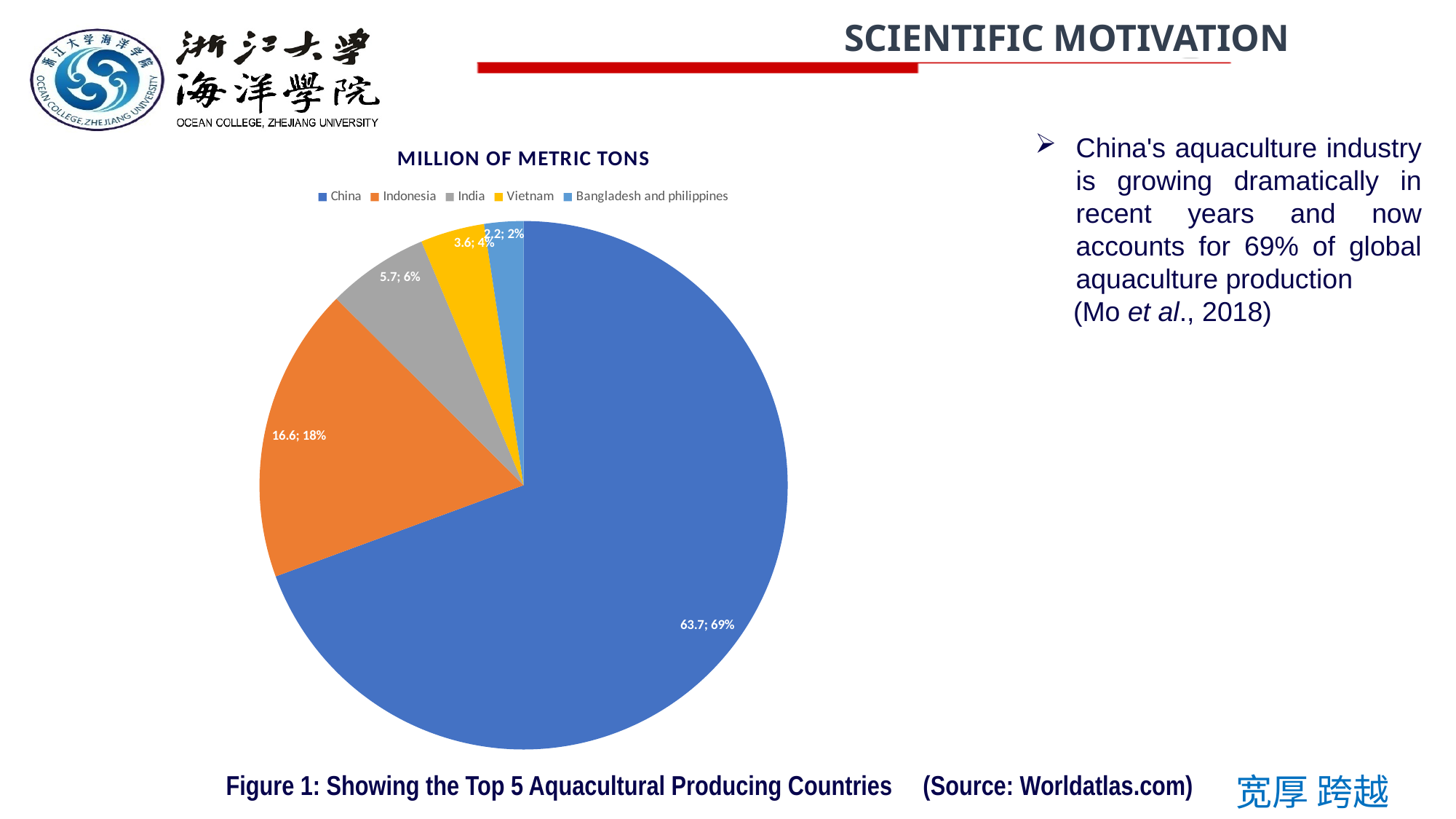
What value is shown for India? 5.7 What value is shown for Indonesia? 16.6 What share of the pie does Indonesia account for? 18% What kind of chart is shown on the slide? pie chart How many slices does the pie chart have? 5 What is the chart's title? MILLION OF METRIC TONS What share of the pie does China account for? 69% What is the difference between the values for China and Indonesia? 47.1 What value is shown for Vietnam? 3.6 What value is shown for China? 63.7 Which category has the smallest slice? Bangladesh and philippines Which country has the largest slice? China